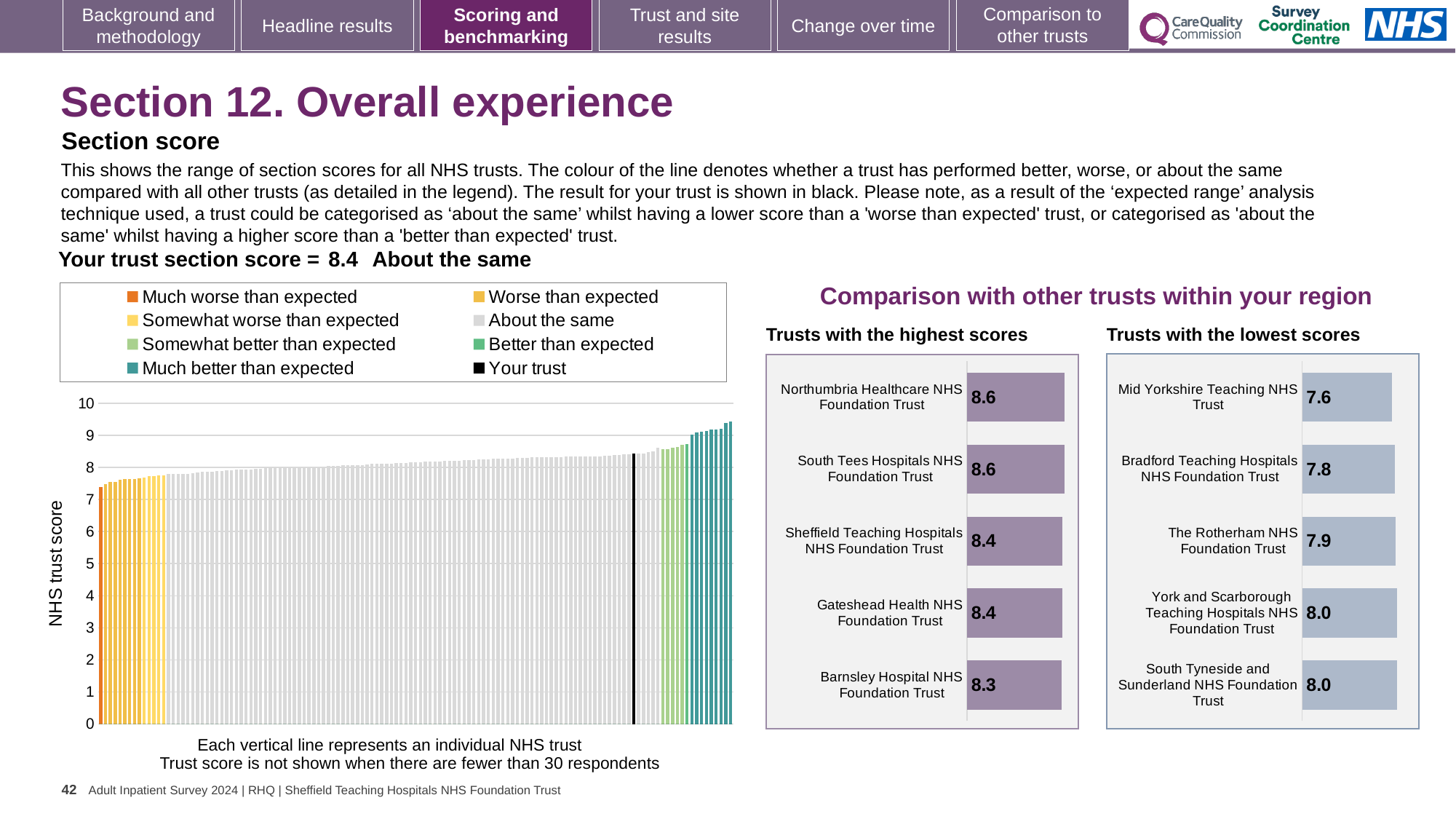
In the 'Trusts with the lowest scores' chart, what is the score for Mid Yorkshire Teaching NHS Trust? 7.6 What is the y-axis label of the large chart on the left? NHS trust score How many entries does the legend of the large chart on the left list? 8 In the 'Trusts with the lowest scores' chart, which has the higher score: Bradford Teaching Hospitals NHS Foundation Trust or The Rotherham NHS Foundation Trust? The Rotherham NHS Foundation Trust In the 'Trusts with the lowest scores' chart, which trust has the lowest score? Mid Yorkshire Teaching NHS Trust In the 'Trusts with the lowest scores' chart, what is the difference between the scores of York and Scarborough Teaching Hospitals NHS Foundation Trust and Mid Yorkshire Teaching NHS Trust? 0.4 How many trusts are listed in the 'Trusts with the highest scores' chart? 5 In the 'Trusts with the highest scores' chart, which trust has the lowest score shown? Barnsley Hospital NHS Foundation Trust In the 'Trusts with the highest scores' chart, what is the difference between the scores of Northumbria Healthcare NHS Foundation Trust and Barnsley Hospital NHS Foundation Trust? 0.3 What kind of chart is the large chart on the left showing NHS trust scores? Bar chart In the 'Trusts with the highest scores' chart, what is the score for Barnsley Hospital NHS Foundation Trust? 8.3 What is the section score for your trust shown on the slide? 8.4